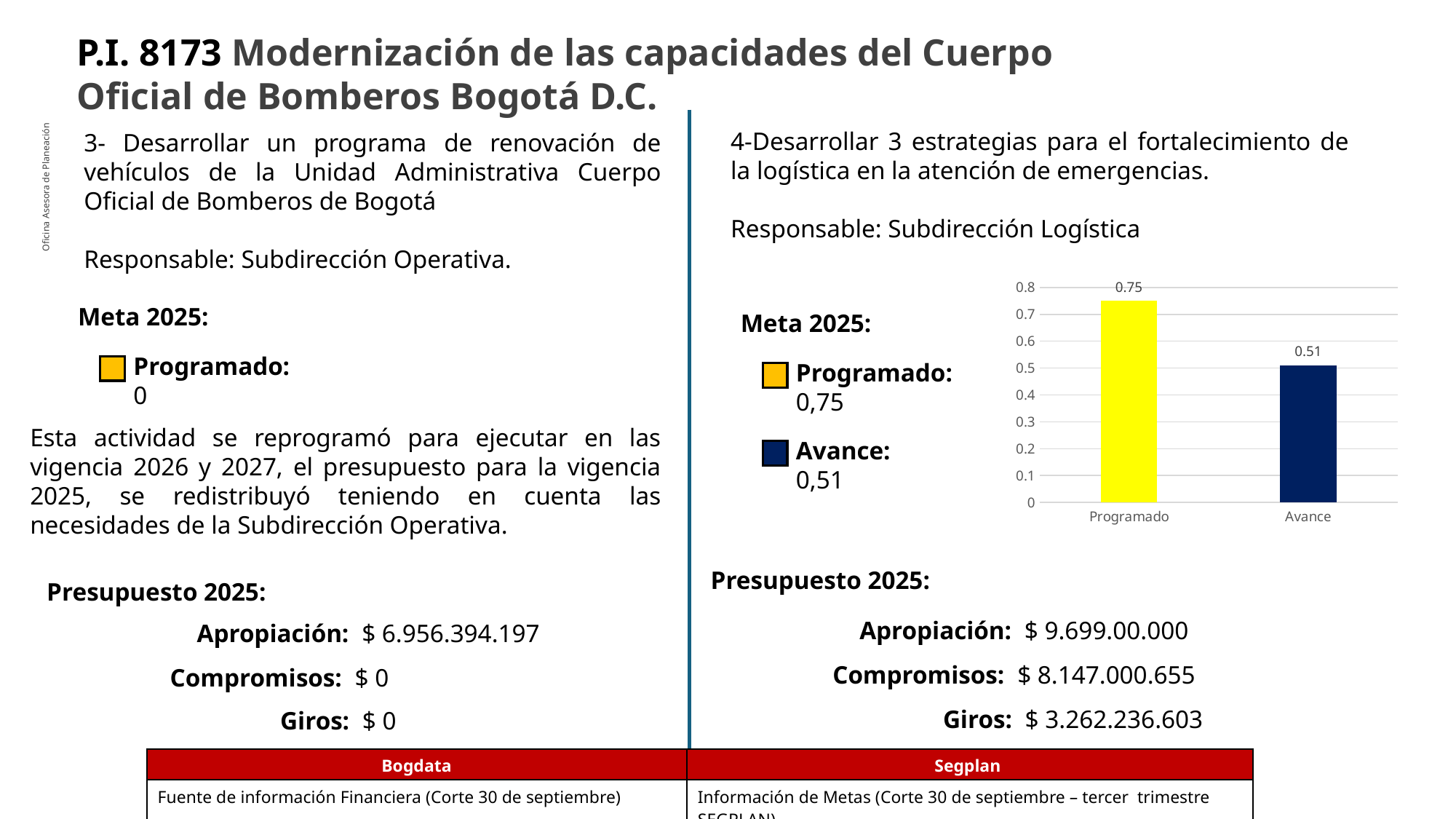
What is the value of the Avance bar in the chart? 0.51 What kind of chart is shown on the slide? Bar chart Is the value for Avance in the chart greater or less than 0.6? less What is the highest value shown on the vertical axis of the chart? 0.8 How many bars are plotted in the chart? 2 What colour is the Avance bar in the chart? Dark blue Which is larger in the chart, Programado or Avance? Programado Which bar in the chart is the highest? Programado Which bar in the chart is the lowest? Avance What is the difference between the Programado and Avance values in the chart? 0.24 What is the value of the Programado bar in the chart? 0.75 Is the value for Programado in the chart greater or less than 0.7? greater